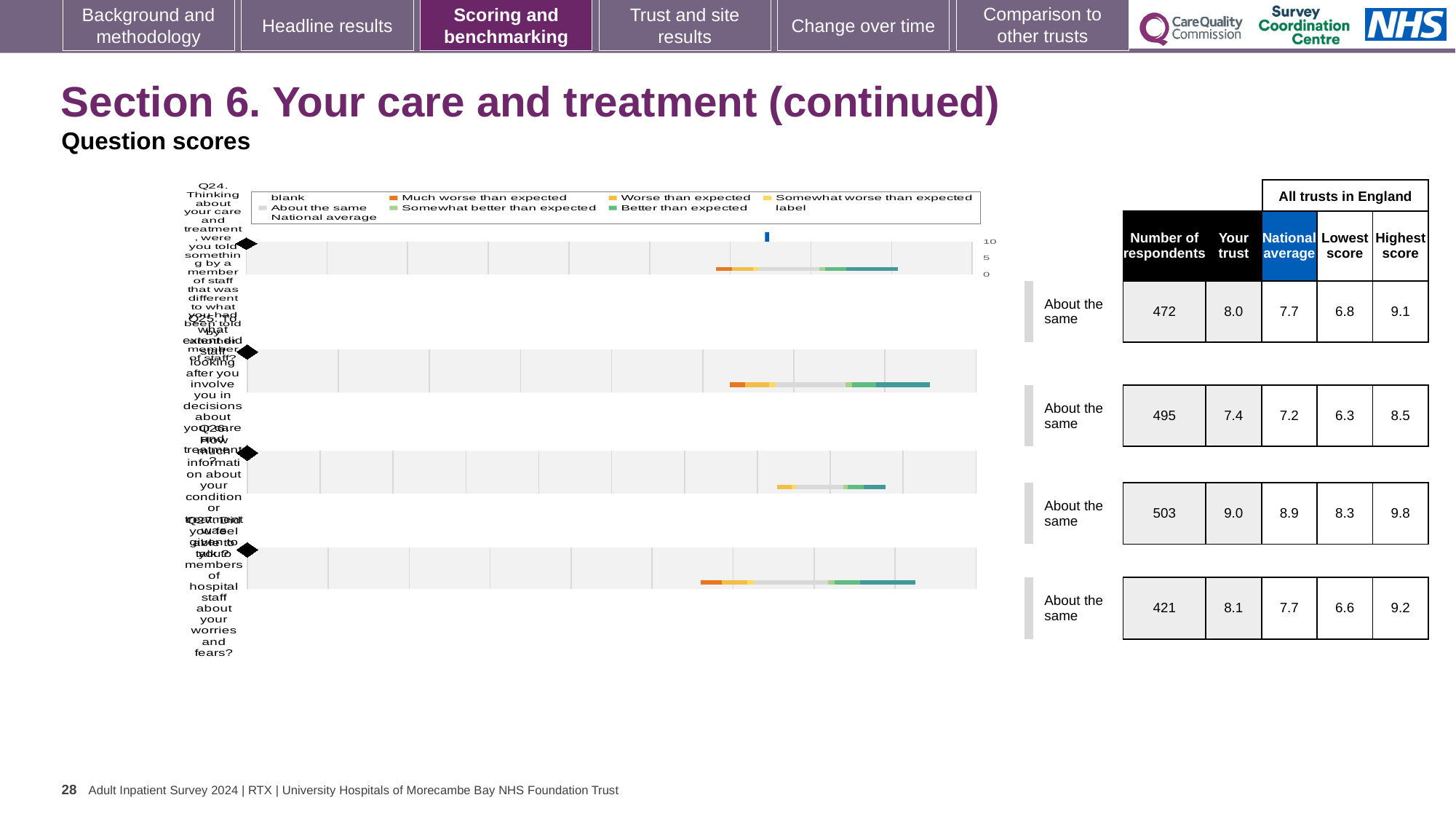
In the table next to the charts, what is the 'Your trust' score for Q24 (first row)? 8.0 For Q25 (second row), which is larger: the 'Your trust' score or the national average? Your trust Which row of the table has the highest 'Your trust' score? Q26 (third row), 9.0 What kind of chart is used for each question on the slide? Bar chart How many question charts are shown on the slide? 4 Which row of the table has the largest number of respondents? Q26 (third row), 503 What benchmark category is shown for all four questions on the slide? About the same In the table next to the charts, what is the highest score for Q26 (third row)? 9.8 Which row of the table has the lowest 'Lowest score' value? Q25 (second row), 6.3 In the table next to the charts, what is the national average for Q25 (second row)? 7.2 In the table next to the charts, how many respondents are listed for Q27 (fourth row)? 421 For Q24 (first row), what is the difference between the 'Your trust' score and the national average? 0.3